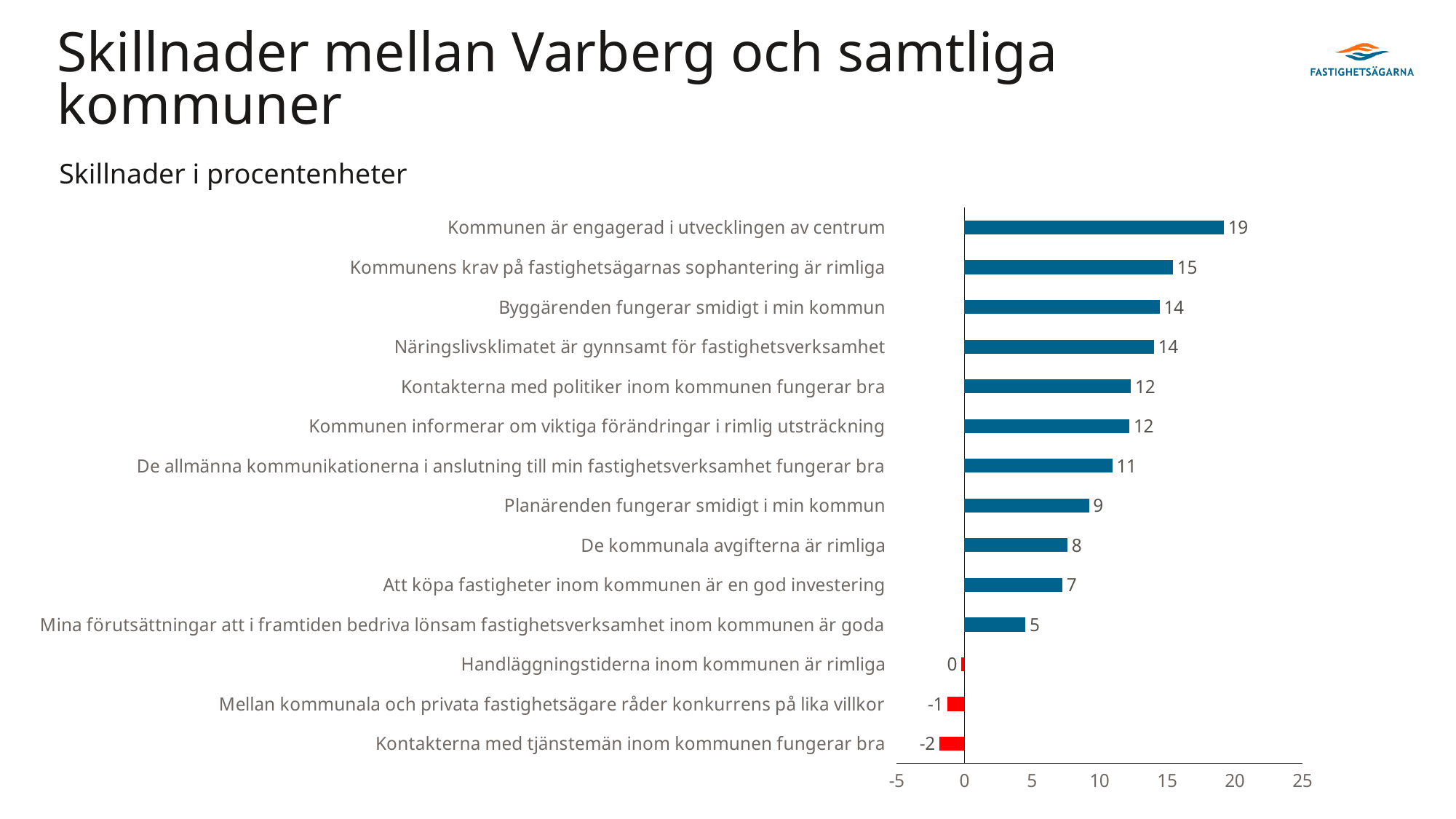
Which is larger: the value for "Byggärenden fungerar smidigt i min kommun" or the value for "Att köpa fastigheter inom kommunen är en god investering"? Byggärenden fungerar smidigt i min kommun What is the value for "Planärenden fungerar smidigt i min kommun"? 9 How many categories have a negative value? 2 What kind of chart is shown on the slide? Bar chart What is the value for "Handläggningstiderna inom kommunen är rimliga"? 0 What is the difference between the values for "Kommunens krav på fastighetsägarnas sophantering är rimliga" and "De kommunala avgifterna är rimliga"? 7 Which category has the lowest value? Kontakterna med tjänstemän inom kommunen fungerar bra What is the value for "Kontakterna med tjänstemän inom kommunen fungerar bra"? -2 Which category has the highest value? Kommunen är engagerad i utvecklingen av centrum What colour are the bars with negative values? Red How many categories are shown in the chart? 14 What is the value for "Kommunen är engagerad i utvecklingen av centrum"? 19